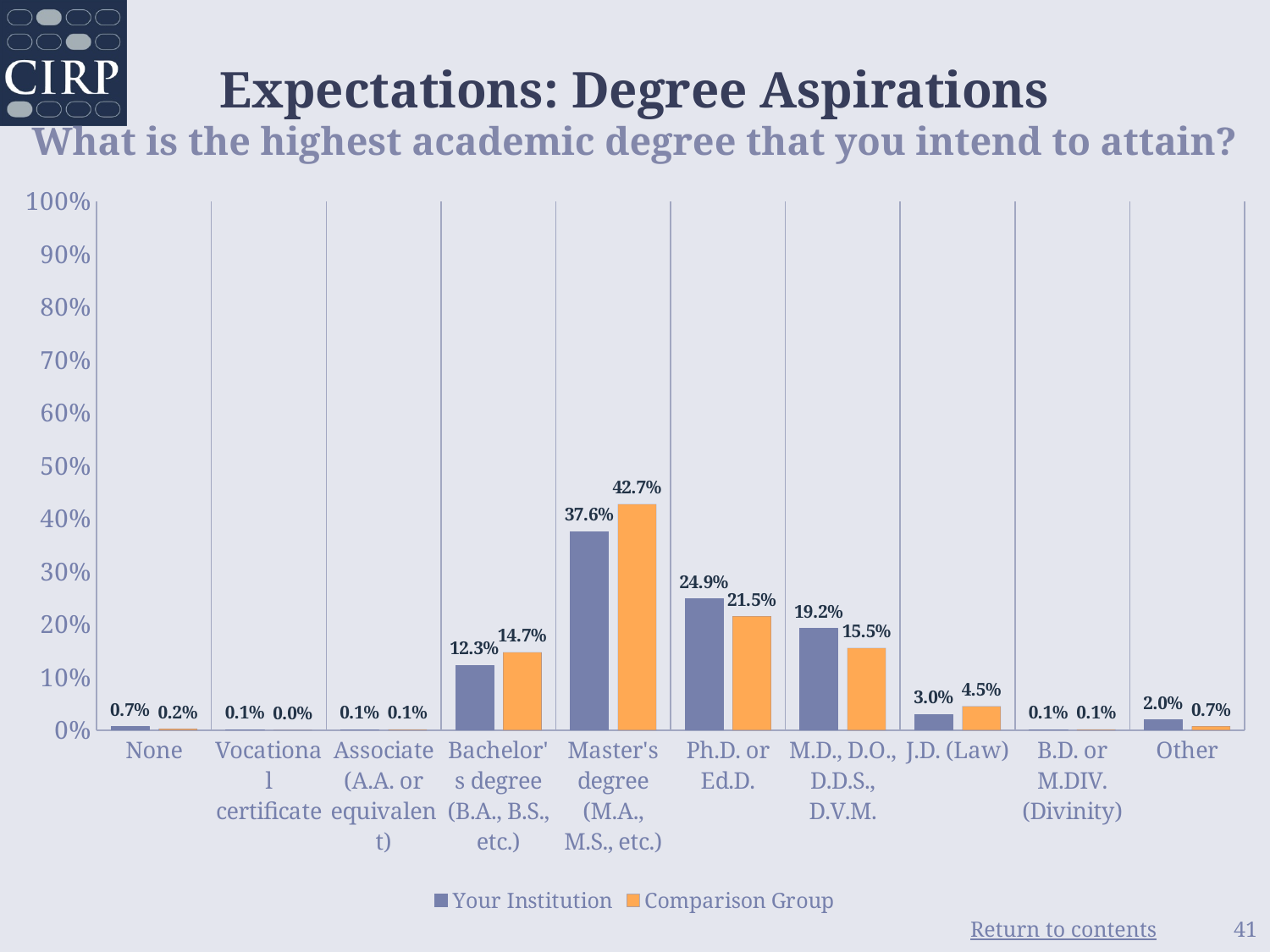
What is the Your Institution value for Master's degree (M.A., M.S., etc.)? 37.6% What is the Your Institution value for J.D. (Law)? 3.0% How many series does the legend list? 2 What is the difference between the Comparison Group and Your Institution values for Master's degree (M.A., M.S., etc.)? 5.1% What is the Comparison Group value for Ph.D. or Ed.D.? 21.5% How many degree categories are shown on the x axis? 10 What is the difference between the Your Institution and Comparison Group values for M.D., D.O., D.D.S., D.V.M.? 3.7% Which degree category has the highest Comparison Group value? Master's degree (M.A., M.S., etc.) For Ph.D. or Ed.D., which is larger: Your Institution or Comparison Group? Your Institution Which degree category has the lowest Comparison Group value? Vocational certificate For Bachelor's degree (B.A., B.S., etc.), which is larger: Your Institution or Comparison Group? Comparison Group What kind of chart is shown on the slide? Bar chart